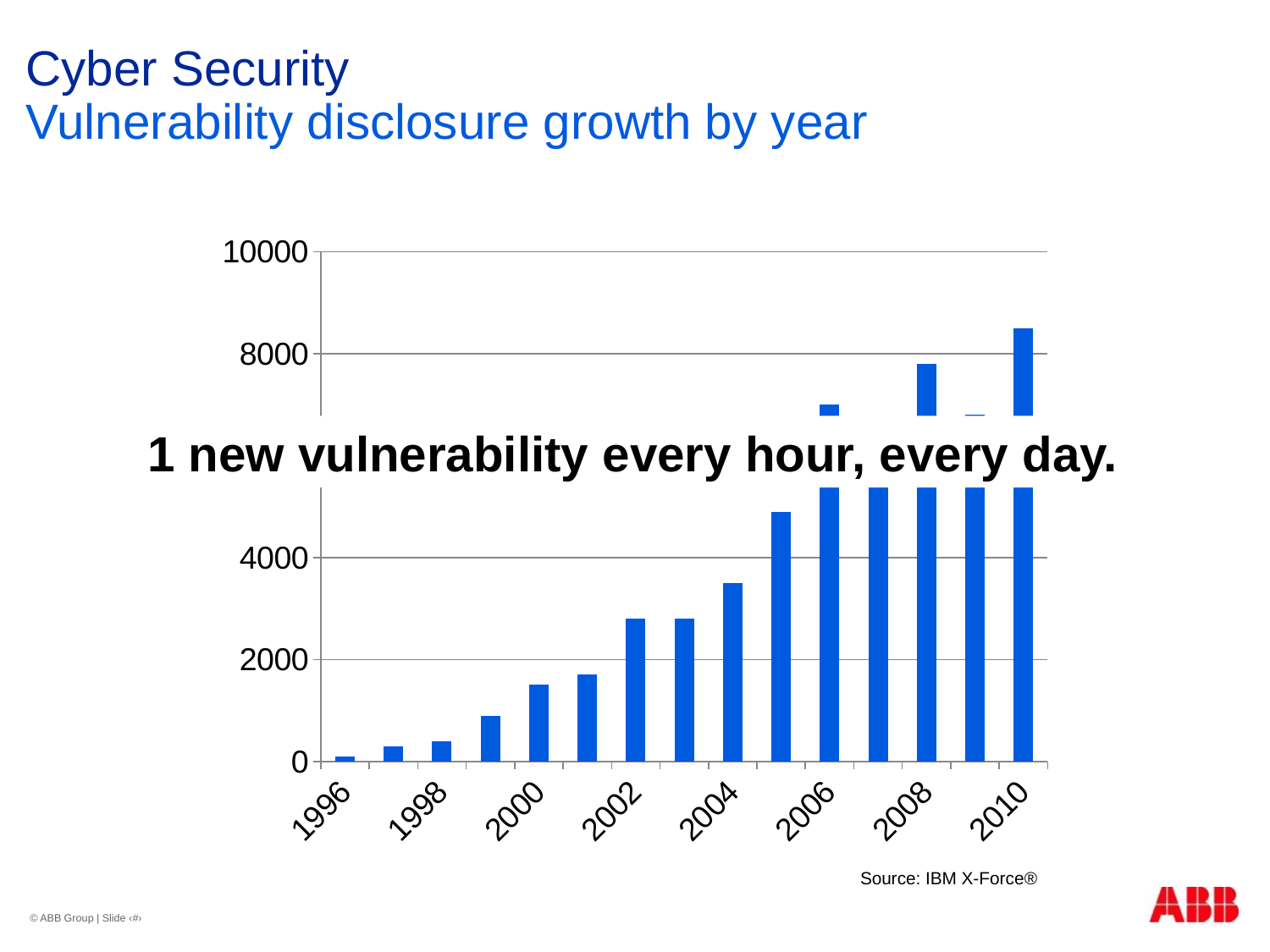
Is the value for 2002 greater or less than 2000? greater What kind of chart is shown on the slide? bar chart Which year has a higher value, 1996 or 1998? 1998 What source is cited for the chart data? IBM X-Force® Which year has a higher value, 2008 or 2010? 2010 Which year has the lowest number of vulnerability disclosures? 1996 Is the value for 2004 greater or less than 4000? less Which year has the highest number of vulnerability disclosures? 2010 Is the value for 2005 greater or less than 4000? greater Do the values generally rise or fall from 1996 to 2010? rise